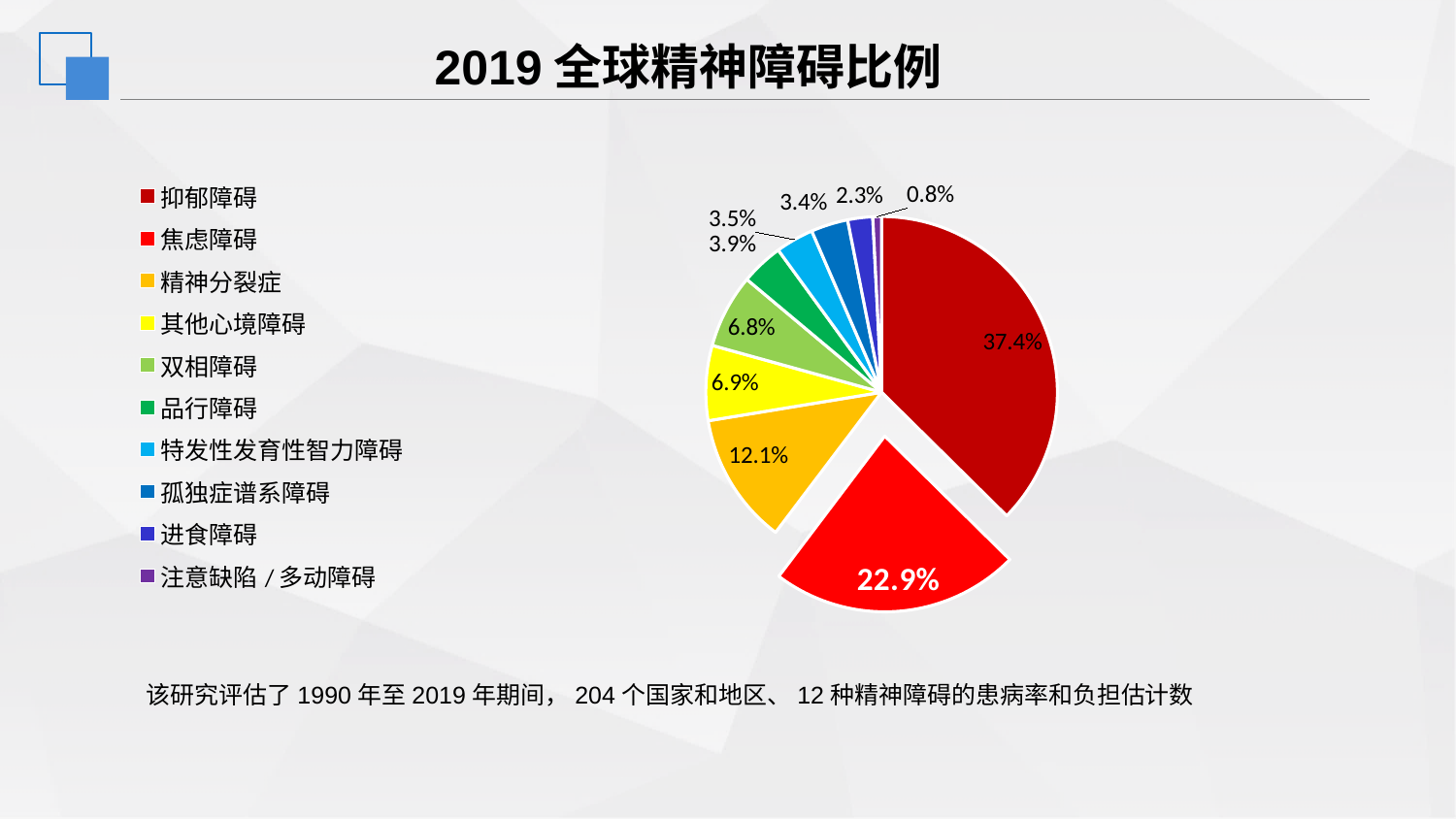
What is the share for 双相障碍? 6.8% Which is larger, the share for 精神分裂症 or the share for 其他心境障碍? 精神分裂症 What is the share for 抑郁障碍? 37.4% What is the difference between the shares of 抑郁障碍 and 焦虑障碍? 14.5% What is the share for 注意缺陷 / 多动障碍? 0.8% Which category has the smallest slice of the pie? 注意缺陷 / 多动障碍 What is the title of the chart? 2019 全球精神障碍比例 Which category has the largest slice of the pie? 抑郁障碍 How many categories does the legend list? 10 What kind of chart is shown on the slide? pie chart What is the share for 精神分裂症? 12.1% What is the share for 焦虑障碍? 22.9%